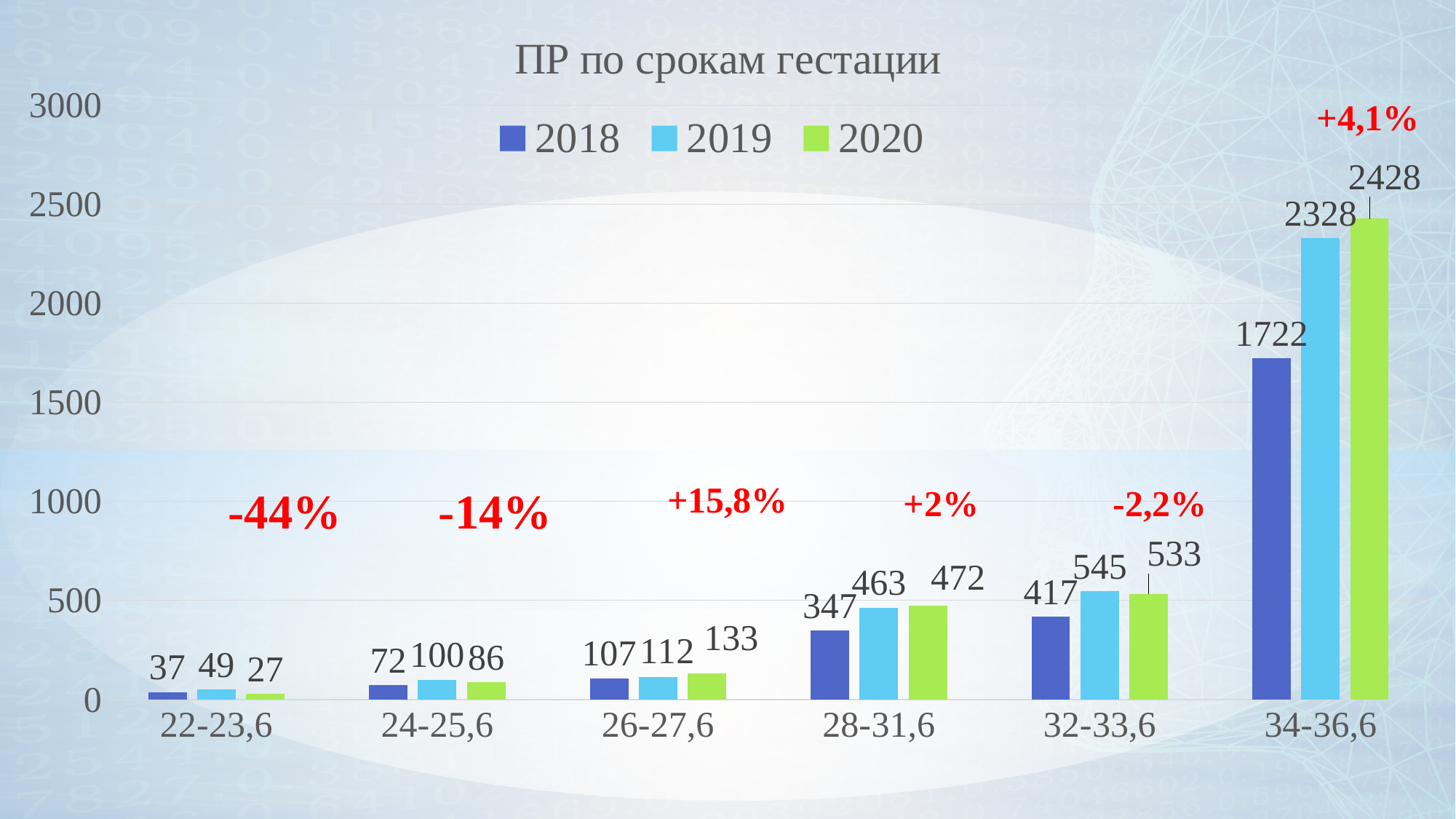
Which is larger in the 32-33,6 category: the 2019 value or the 2020 value? 2019 How many gestation-period categories are shown on the x axis? 6 What is the difference between the 2019 and 2018 values in the 34-36,6 category? 606 What is the value for 2018 in the 28-31,6 category? 347 What is the value for 2019 in the 24-25,6 category? 100 Which category has the lowest value for 2020? 22-23,6 What percentage change is printed in red above the 22-23,6 category? -44% What kind of chart is shown on the slide? bar chart What is the title of the chart? ПР по срокам гестации Which category has the highest value for 2019? 34-36,6 How many series does the legend list? 3 What is the value for 2020 in the 34-36,6 category? 2428